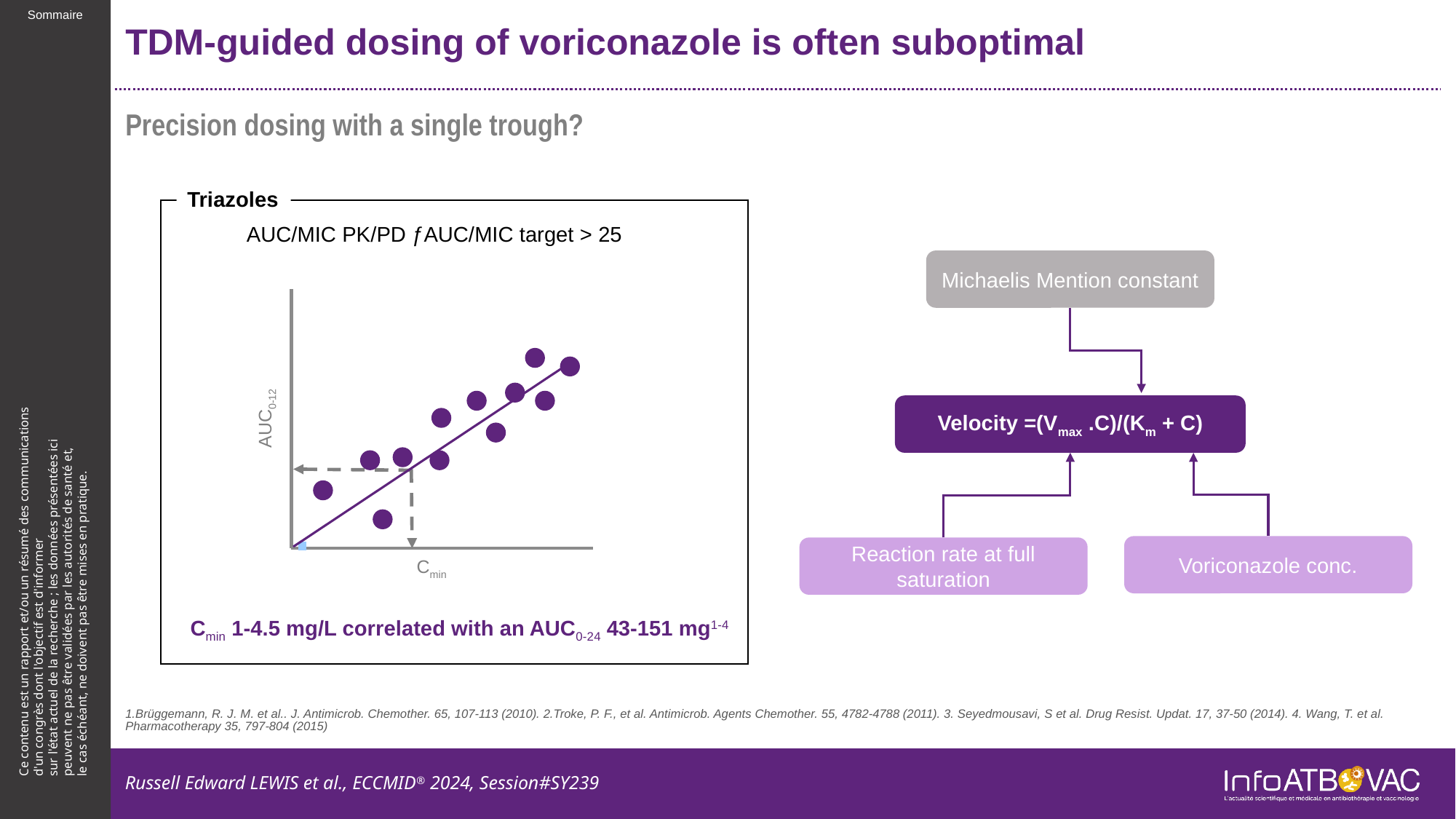
What kind of chart is shown in the Triazoles box? scatter chart What is the label of the y axis of the scatter chart? AUC0-12 How many data points are plotted in the scatter chart? 12 What is the label of the x axis of the scatter chart? Cmin In the scatter chart, do the AUC0-12 values rise or fall as Cmin increases along the x axis? rise